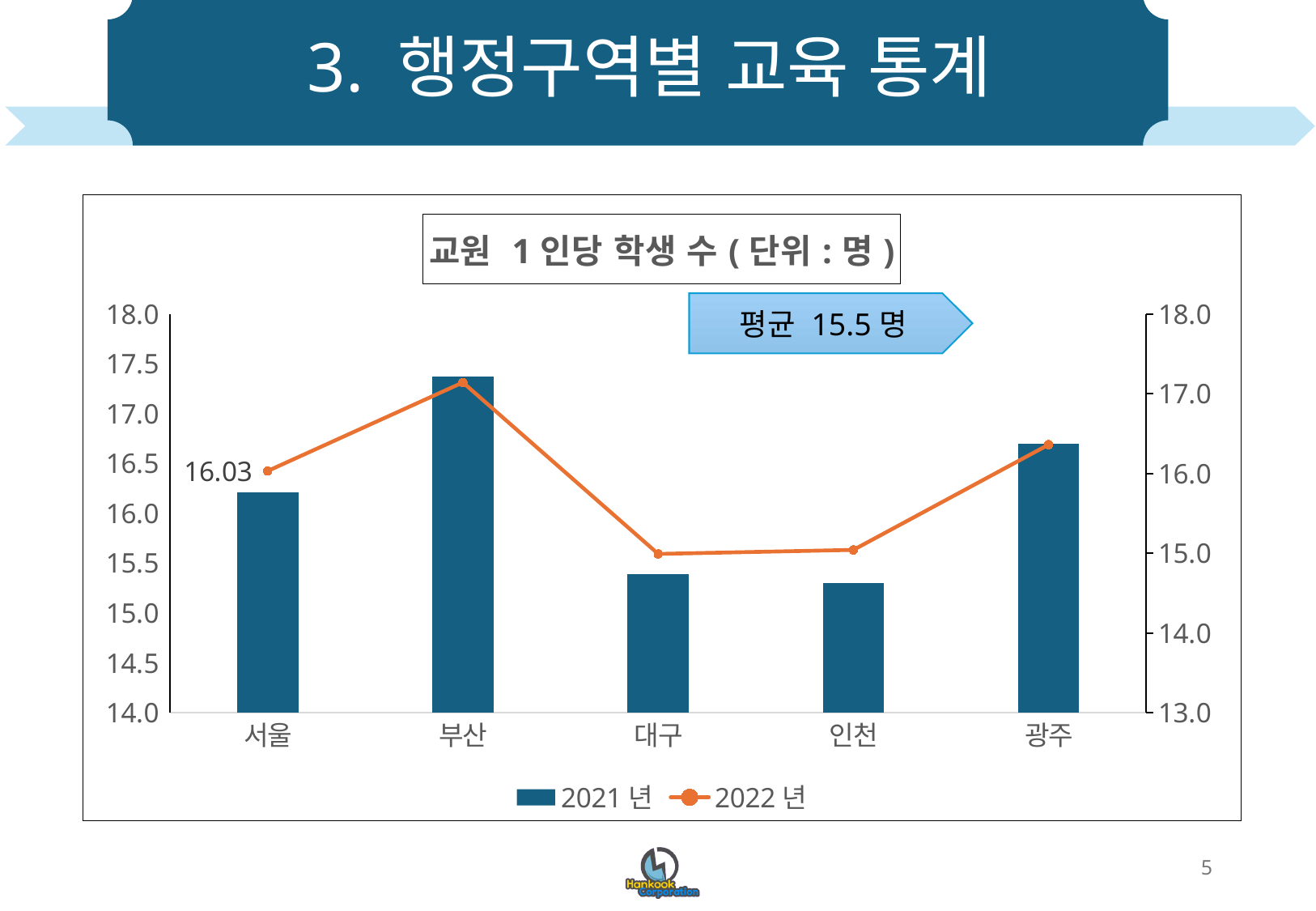
Which region has the highest 2021년 bar? 부산 What is the title of the chart? 교원 1인당 학생 수 (단위 : 명) What average value is shown in the callout on the chart? 평균 15.5 명 What value is printed as a data label next to the 서울 point on the 2022년 line? 16.03 Is the 2021년 value for 광주 greater or less than 16.5? greater Which region has the highest 2022년 value on the line? 부산 How many series does the chart legend list? 2 Which has the larger 2021년 value, 서울 or 광주? 광주 What kind of chart is shown on the slide? Combination bar and line chart Is the 2021년 value for 대구 greater or less than 15.5? less How many regions are shown on the x axis of the chart? 5 Is the 2021년 value for 부산 greater or less than 17.0? greater